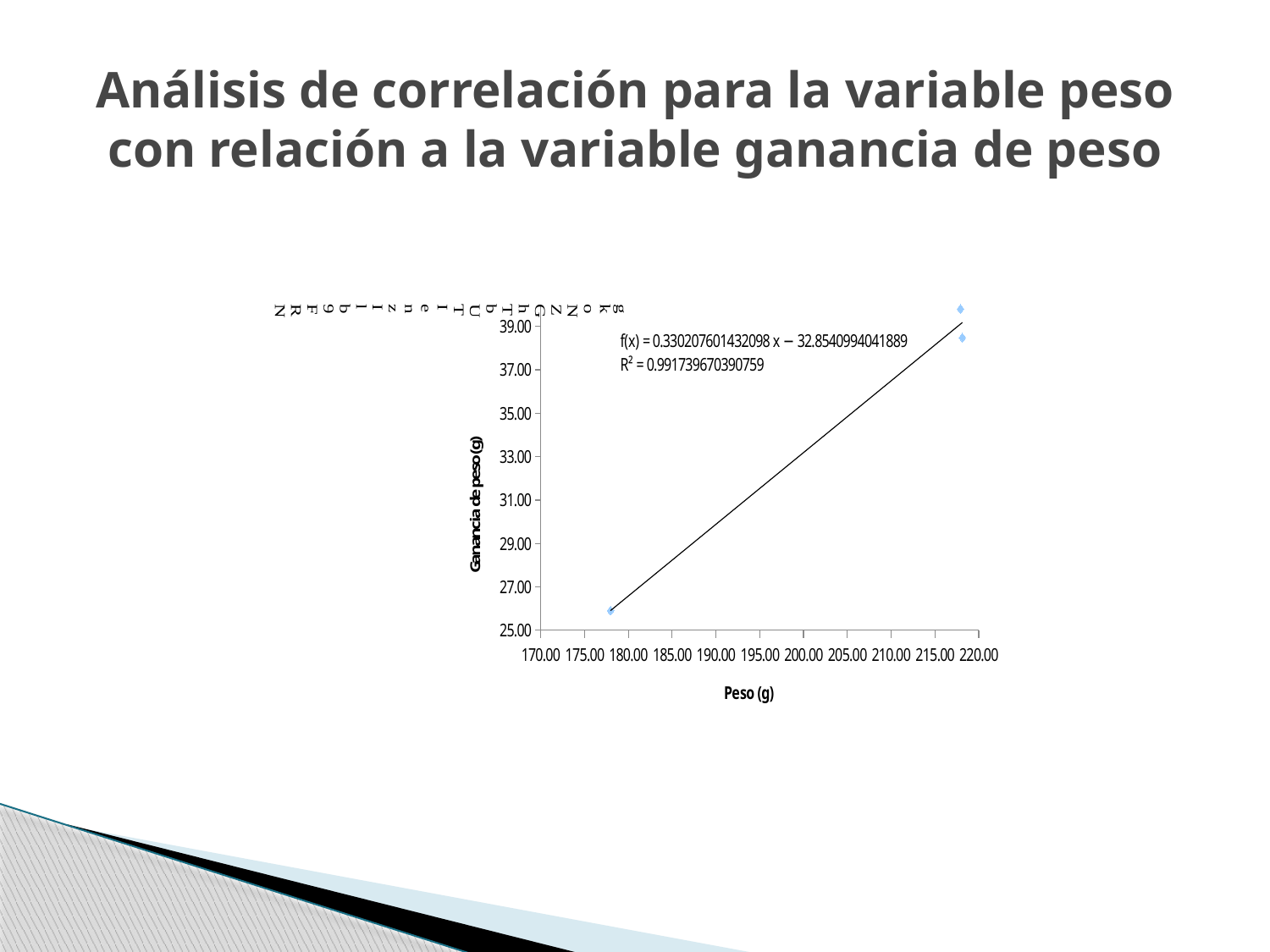
How many data points are plotted on the chart? 3 Is the Peso value of the rightmost data points greater or less than 215.00? greater Is the Ganancia de peso value for the highest data point greater or less than 37.00? greater What R² value is printed on the chart? 0.991739670390759 What kind of chart is shown on the slide? scatter chart Is the Peso value of the leftmost data point greater or less than 180.00? less What is the title of the y axis of the chart? Ganancia de peso (g) What is the title of the x axis of the chart? Peso (g) Do the values of Ganancia de peso rise or fall as Peso increases along the x axis? rise What is the trendline equation printed on the chart? f(x) = 0.330207601432098 x − 32.8540994041889 What is the highest tick value shown on the x axis? 220.00